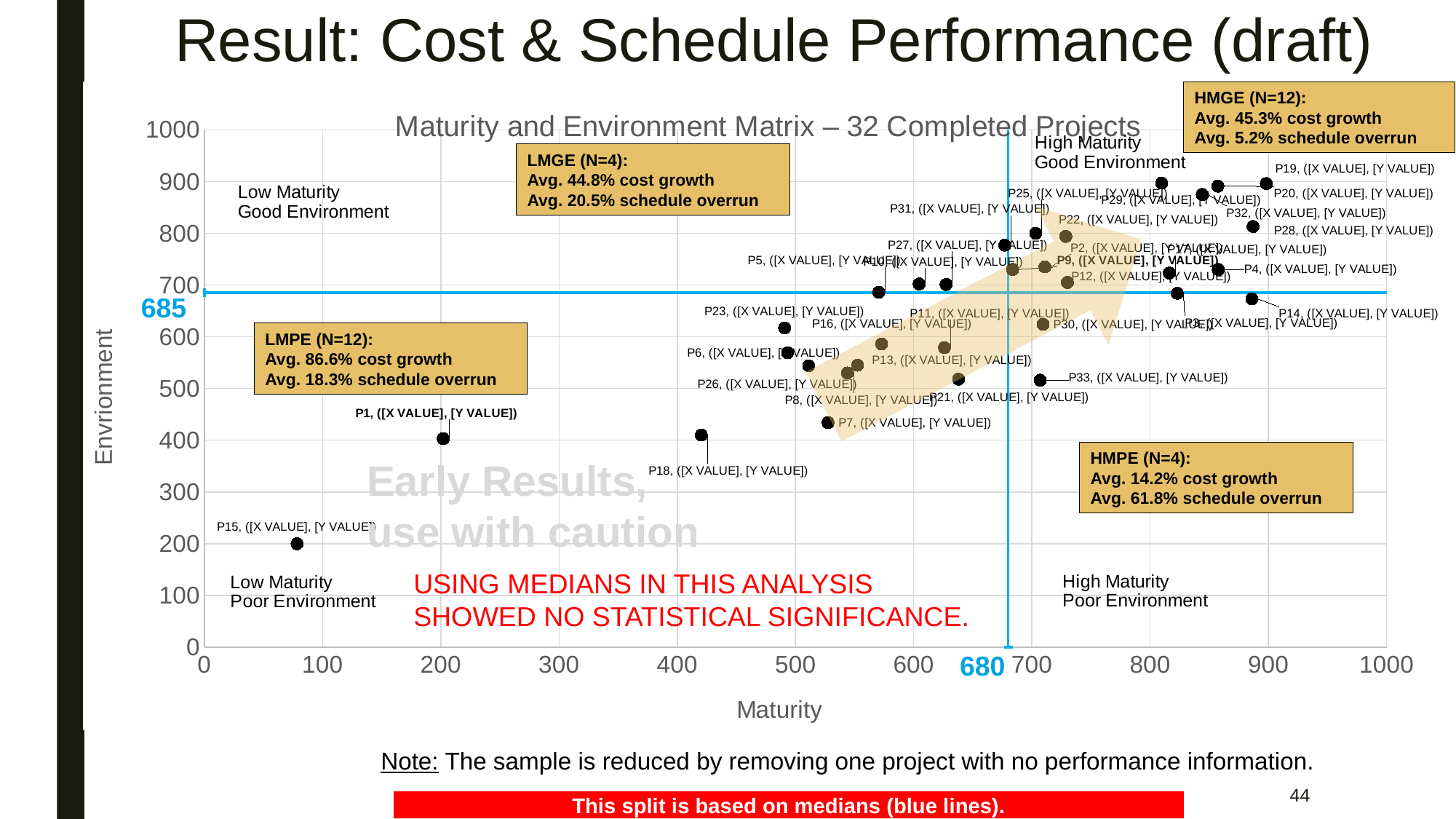
What are the labels of the x axis and the y axis of the chart? Maturity (x axis), Environment (y axis) What Environment value is marked by the horizontal blue median line? 685 Which project has the higher Environment value, P19 or P18? P19 How many completed projects does the chart title say are plotted? 32 What Maturity value is marked by the vertical blue median line? 680 What kind of chart is shown on the slide? scatter chart Is the Environment value for P15 greater or less than 300? less Which project has the lowest Maturity value on the chart? P15 What is the title of the chart? Maturity and Environment Matrix – 32 Completed Projects Is the Maturity value for P15 greater or less than 100? less Is the Environment value for P7 greater or less than 400? greater Which project has the lowest Environment value on the chart? P15